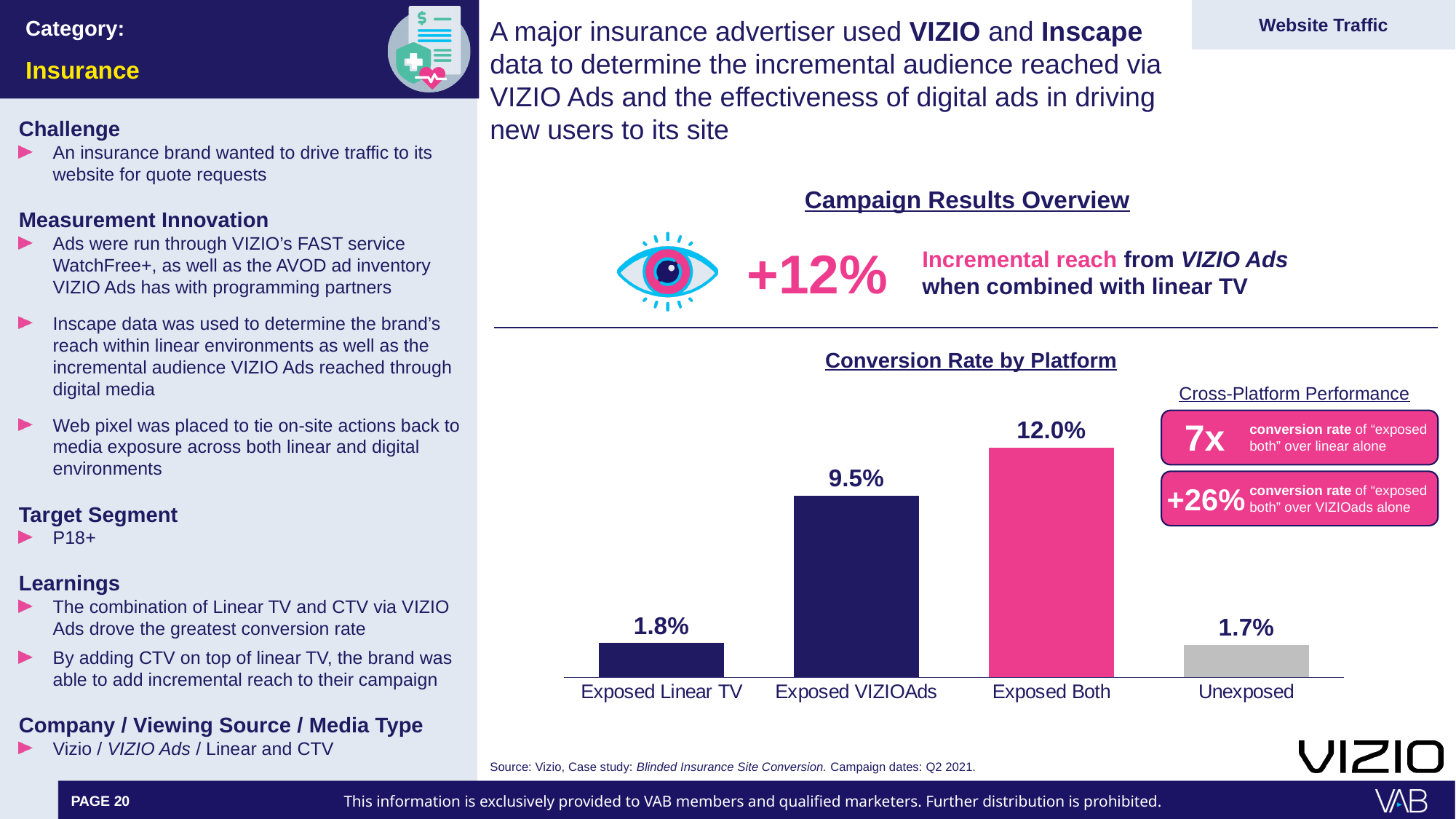
What is the conversion rate for Exposed Linear TV? 1.8% What is the difference in conversion rate between Exposed Linear TV and Unexposed? 0.1% Which has a higher conversion rate, Exposed VIZIOAds or Exposed Linear TV? Exposed VIZIOAds What is the conversion rate for Exposed VIZIOAds? 9.5% What type of chart is the Conversion Rate by Platform chart? Bar chart Which platform has the highest conversion rate? Exposed Both What is the conversion rate for Exposed Both in the Conversion Rate by Platform chart? 12.0% Which category has the lowest conversion rate? Unexposed What is the difference in conversion rate between Exposed Both and Exposed VIZIOAds? 2.5% What is the conversion rate for the Unexposed group? 1.7% What is the title of the chart on the slide? Conversion Rate by Platform How many categories are shown in the Conversion Rate by Platform chart? 4